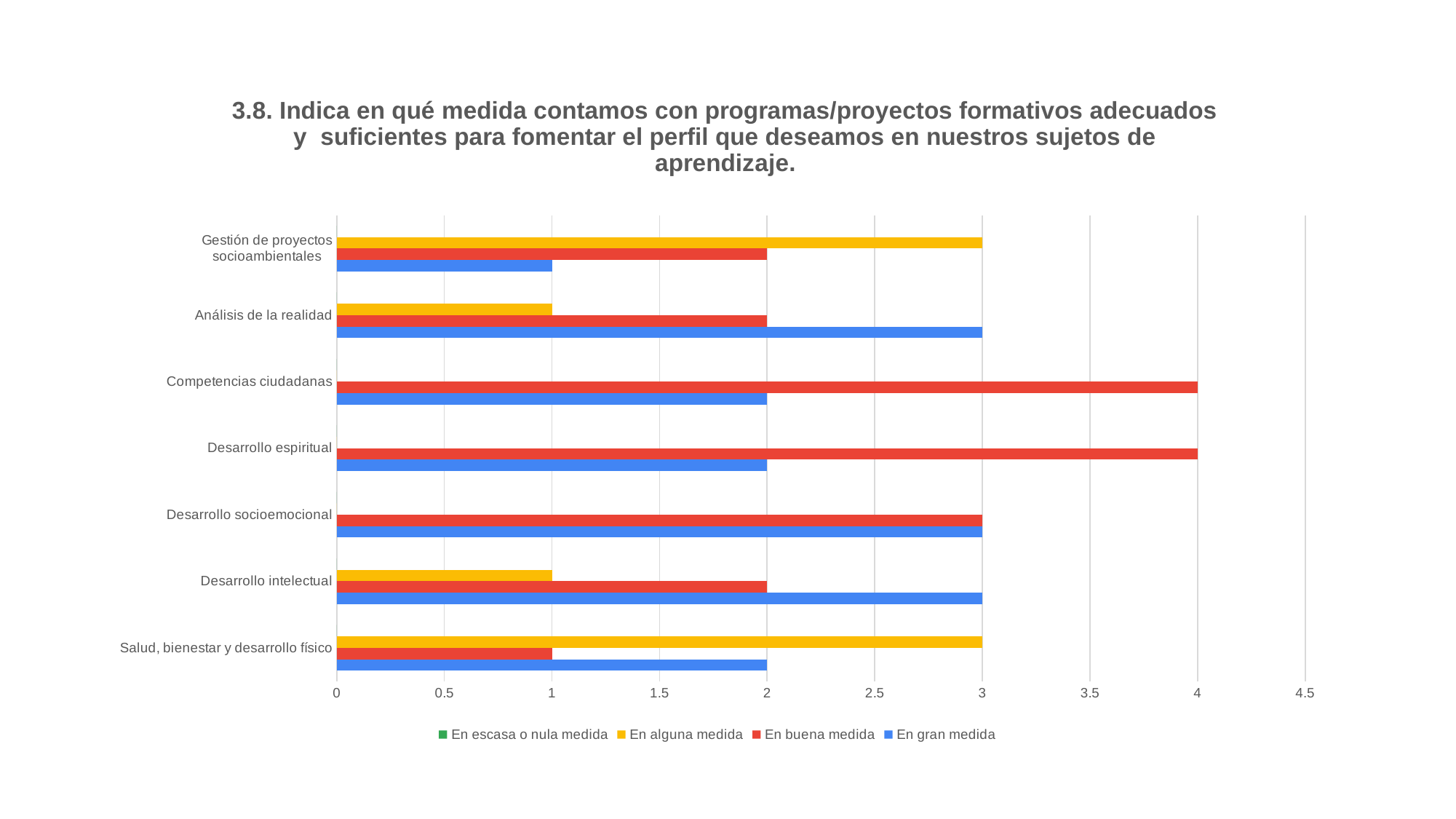
Which legend entry is shown in green? En escasa o nula medida Which is larger for Desarrollo intelectual: 'En gran medida' or 'En alguna medida'? En gran medida How many series does the legend list? 4 What kind of chart is shown on the slide? bar chart What is the value of 'En gran medida' for Gestión de proyectos socioambientales? 1 What is the value of 'En gran medida' for Análisis de la realidad? 3 Is the value of 'En buena medida' for Desarrollo socioemocional greater or less than 2? greater Which category has the highest value for 'En alguna medida'? Gestión de proyectos socioambientales and Salud, bienestar y desarrollo físico (both 3) How many categories are shown on the vertical axis? 7 What is the difference between 'En buena medida' and 'En gran medida' for Desarrollo espiritual? 2 What is the value of 'En buena medida' for Competencias ciudadanas? 4 What is the value of 'En alguna medida' for Salud, bienestar y desarrollo físico? 3